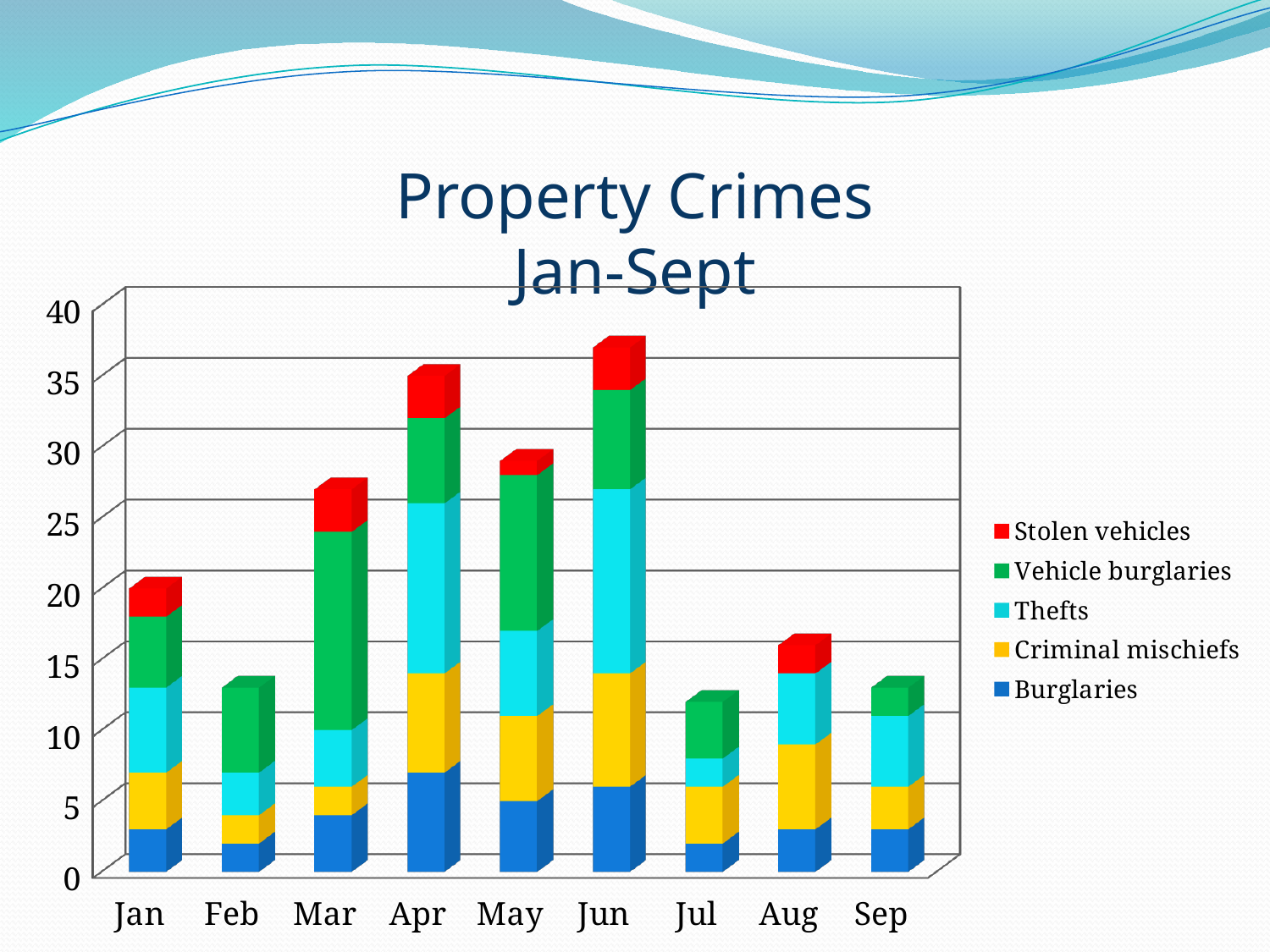
Which month has the larger total, Mar or Aug? Mar How many months are shown on the x axis of the chart? 9 Is the total for Jun greater or less than 35? greater Is the total for Mar greater or less than 25? greater What kind of chart is shown on the slide? Stacked bar chart Which month has the highest total of property crimes? Jun Is the total for Jul greater or less than 15? less How many series does the legend list? 5 Which series is shown in red in the legend? Stolen vehicles What is the title of the chart? Property Crimes Jan-Sept Which month has the larger total, Apr or May? Apr